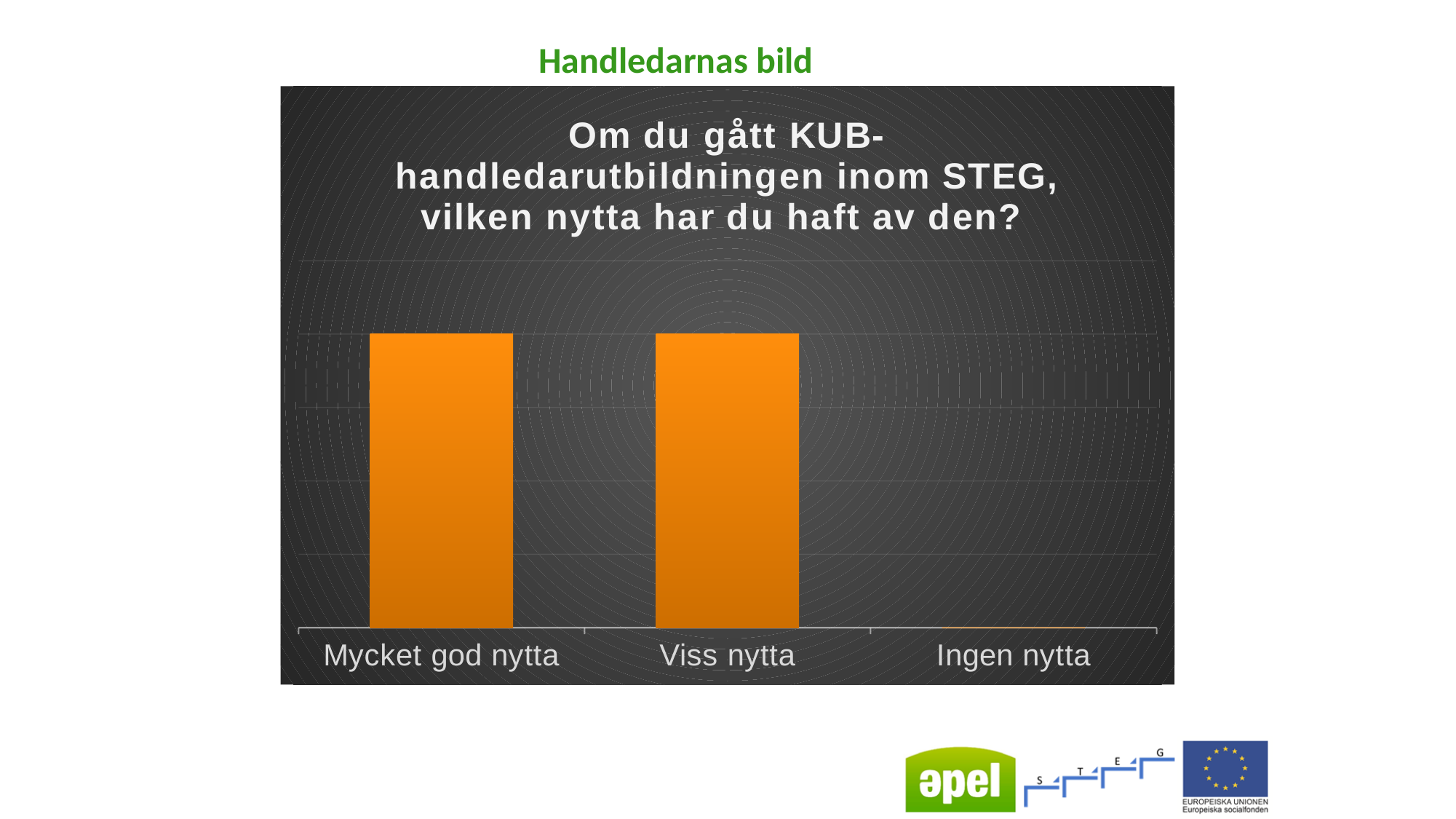
How many categories are shown on the x axis of the chart? 3 Which is larger, the value for Mycket god nytta or the value for Ingen nytta? Mycket god nytta What is the title of the chart? Om du gått KUB-handledarutbildningen inom STEG, vilken nytta har du haft av den? What colour are the bars in the chart? orange What kind of chart is shown on the slide? bar chart Which is larger, the value for Viss nytta or the value for Ingen nytta? Viss nytta What is the label of the middle category on the x axis? Viss nytta Which category has the lowest value in the chart? Ingen nytta